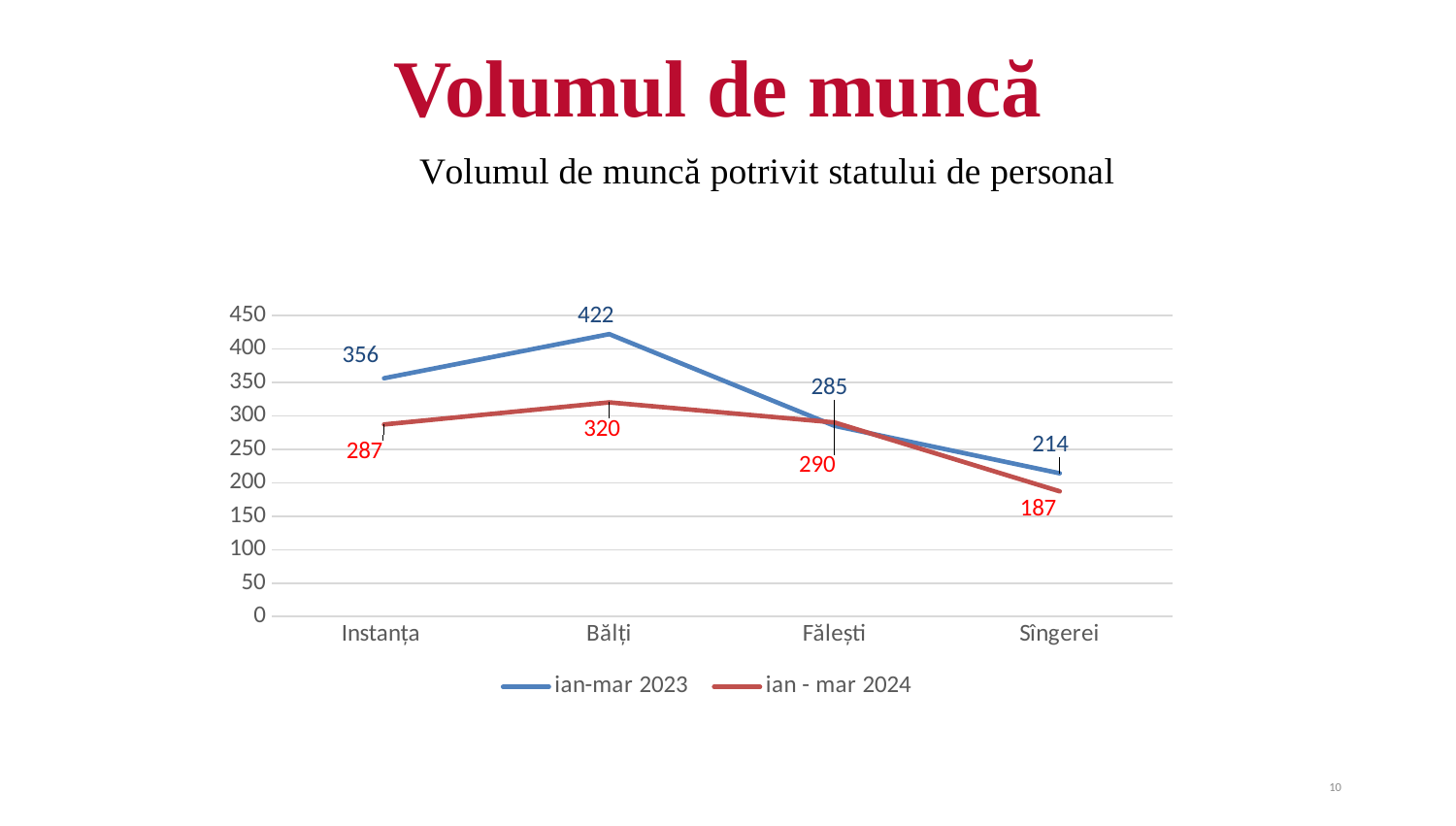
Which is larger for Fălești: the ian-mar 2023 value or the ian - mar 2024 value? ian - mar 2024 How many categories are shown on the x axis? 4 Which category has the lowest value in the ian - mar 2024 series? Sîngerei How many series does the legend list? 2 Which category has the highest value in the ian-mar 2023 series? Bălți Does the ian-mar 2023 series rise or fall from Bălți to Sîngerei? fall What is the value for Sîngerei in the ian - mar 2024 series? 187 What is the difference between the ian-mar 2023 and ian - mar 2024 values for Instanța? 69 What is the difference between the ian-mar 2023 and ian - mar 2024 values for Bălți? 102 What is the value for Bălți in the ian-mar 2023 series? 422 What kind of chart is shown on the slide? line chart What is the value for Instanța in the ian - mar 2024 series? 287